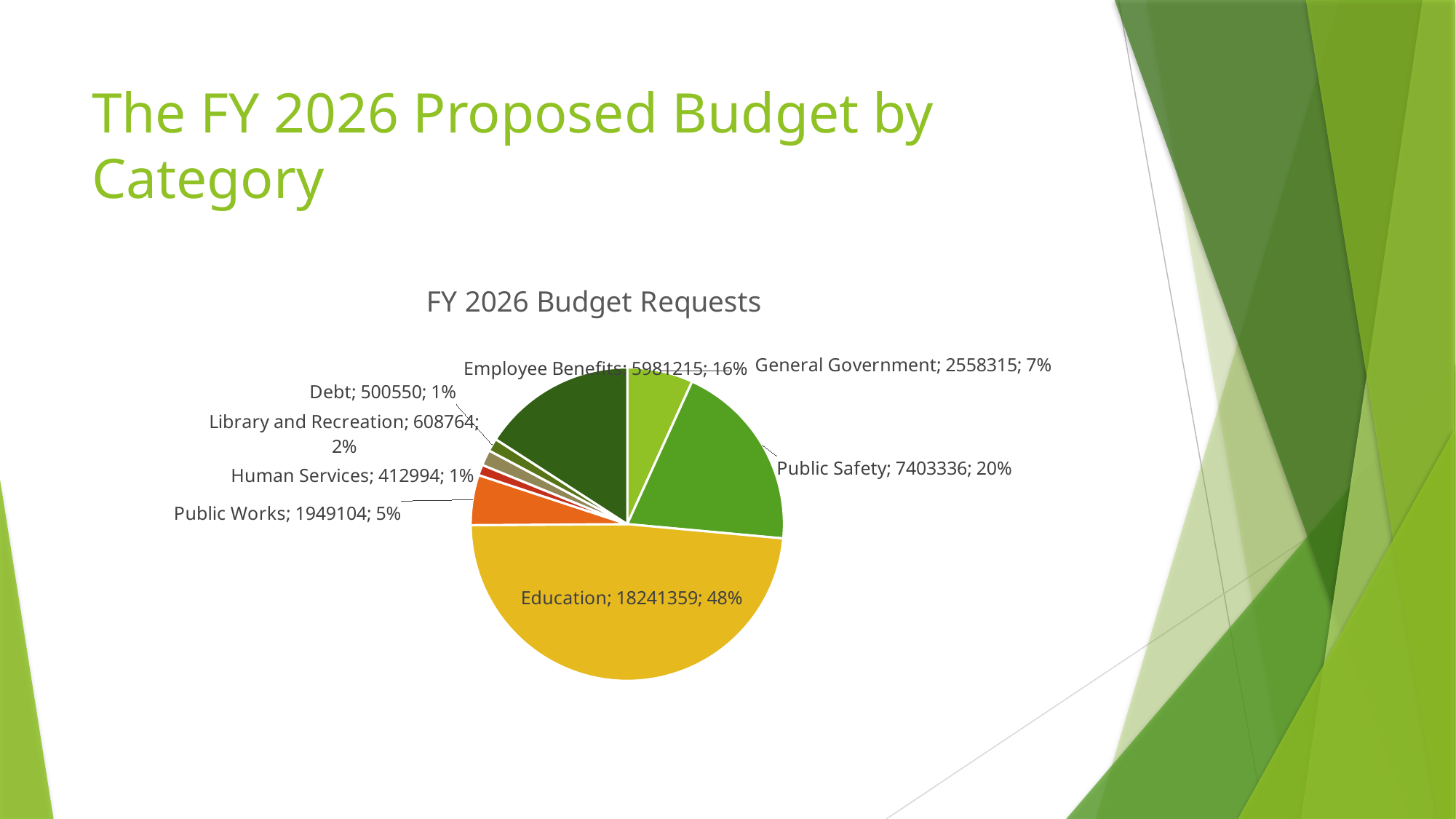
How many categories are shown in the pie chart? 8 What share of the pie does Education represent? 48% Which is larger, the value for Library and Recreation or the value for Debt? Library and Recreation What share of the pie does General Government represent? 7% What is the value for Employee Benefits? 5981215 What is the difference between the values for Public Safety and General Government? 4845021 What type of chart is shown on the slide? pie chart What is the value for Public Works? 1949104 Which category has the smallest value? Human Services What is the value for Public Safety? 7403336 What is the title of the chart? FY 2026 Budget Requests Which category has the largest value? Education